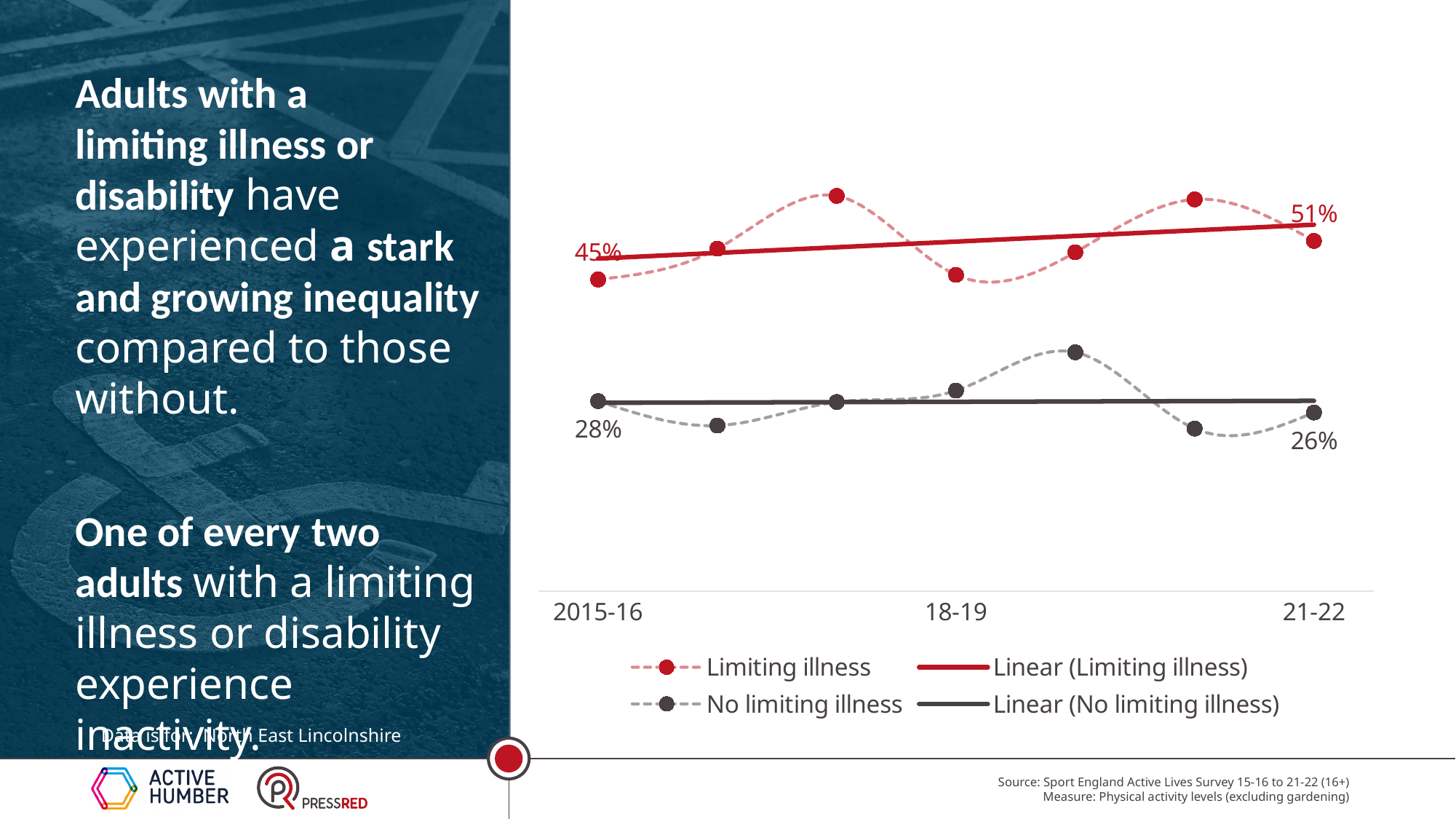
What colour is used for the Limiting illness series? Red By how many percentage points did the Limiting illness value change between 2015-16 and 21-22? 6 percentage points What is the value for No limiting illness in 2015-16? 28% How many data points are plotted for the Limiting illness series? 7 What is the value for Limiting illness in 2015-16? 45% What kind of chart is shown on the slide? Line chart What is the value for Limiting illness in 21-22? 51% How many entries does the chart legend list? 4 What is the value for No limiting illness in 21-22? 26% Does the Limiting illness value rise or fall from 2015-16 to 21-22? Rise Which series has the higher value in 2015-16, Limiting illness or No limiting illness? Limiting illness What is the difference between the Limiting illness and No limiting illness values in 21-22? 25 percentage points